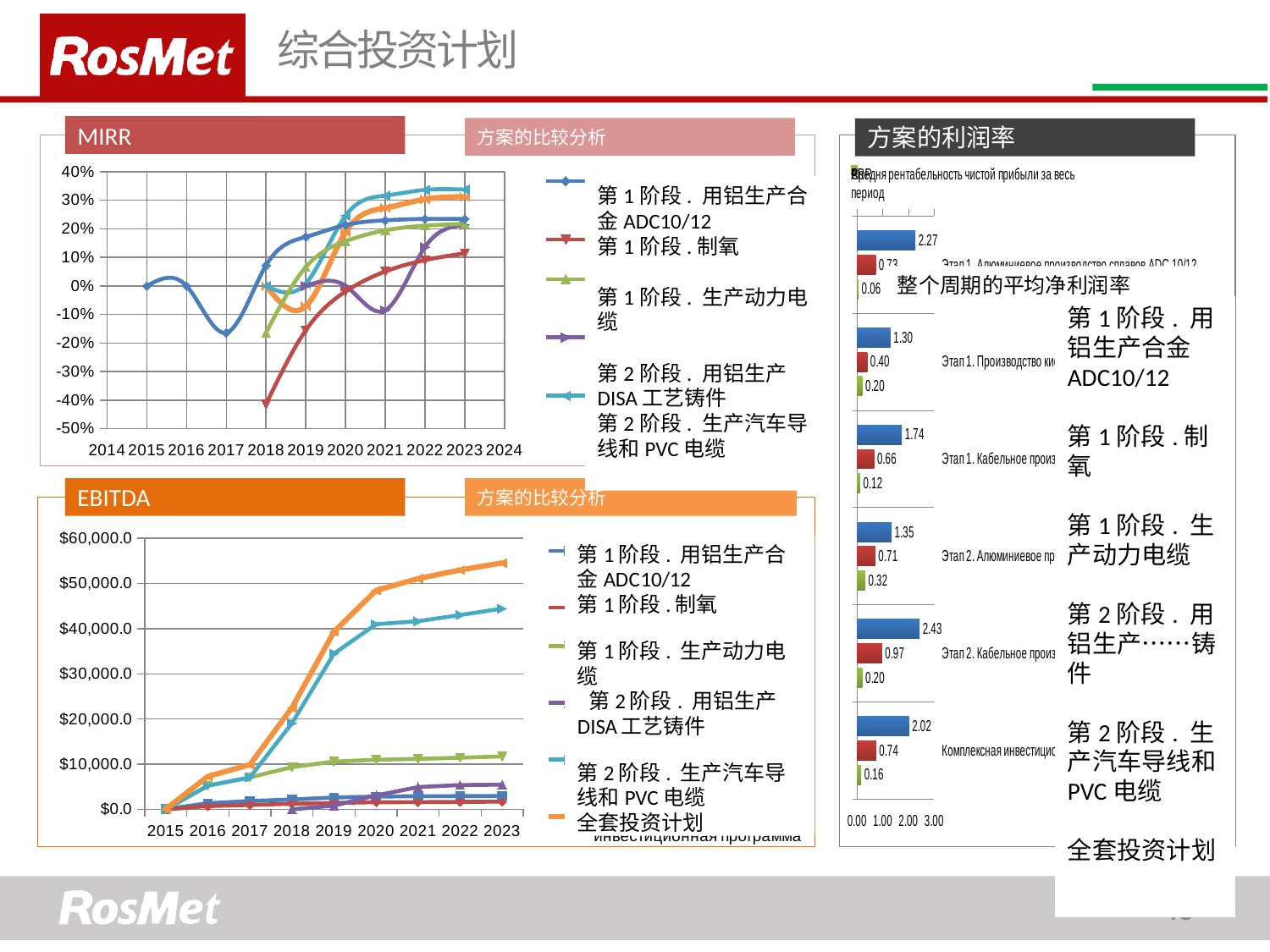
What kind of chart is the MIRR chart on the top left? line chart In the MIRR chart, how many years are shown on the x axis? 11 In the EBITDA chart, how many years are shown on the x axis? 9 In the EBITDA chart, how many series does the legend list? 6 In the MIRR chart, is the value of the 第 1 阶段 . 用铝生产合金 ADC10/12 line in 2017 greater or less than -10%? less In the 方案的利润率 chart on the right, what is the highest value shown on a blue bar? 2.43 In the 方案的利润率 chart on the right, what is the value of the blue bar in the topmost group? 2.27 In the 方案的利润率 chart on the right, what is the lowest value shown on any bar? 0.06 In the EBITDA chart, is the value of the 全套投资计划 line in 2023 greater or less than $50,000.0? greater In the EBITDA chart, does the 全套投资计划 line rise or fall from 2015 to 2023? rise What kind of chart is the 方案的利润率 chart on the right? bar chart In the 方案的利润率 chart on the right, how many groups of bars are there? 6